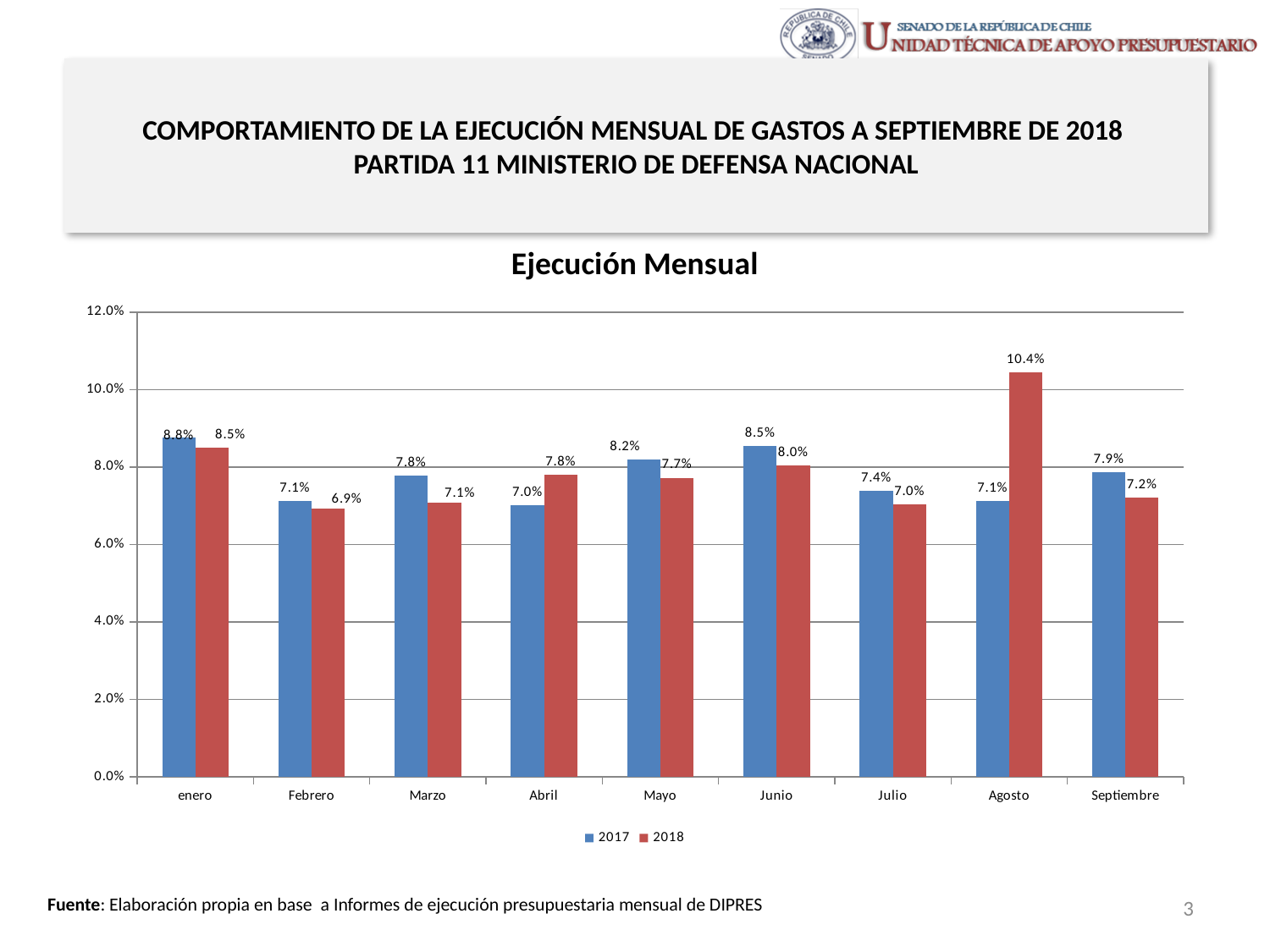
What is the value for 2018 in Febrero? 6.9% What is the difference between the 2018 and 2017 values in Agosto? 3.3% How many months are shown on the x axis? 9 What is the value for 2018 in Agosto? 10.4% What is the value for 2017 in enero? 8.8% How many series does the legend list? 2 What kind of chart is shown on the slide? Bar chart Which month has the highest value for the 2018 series? Agosto What is the value for 2017 in Mayo? 8.2% Which month has the highest value for the 2017 series? enero In Abril, which series has the larger value, 2017 or 2018? 2018 Which month has the lowest value for the 2018 series? Febrero